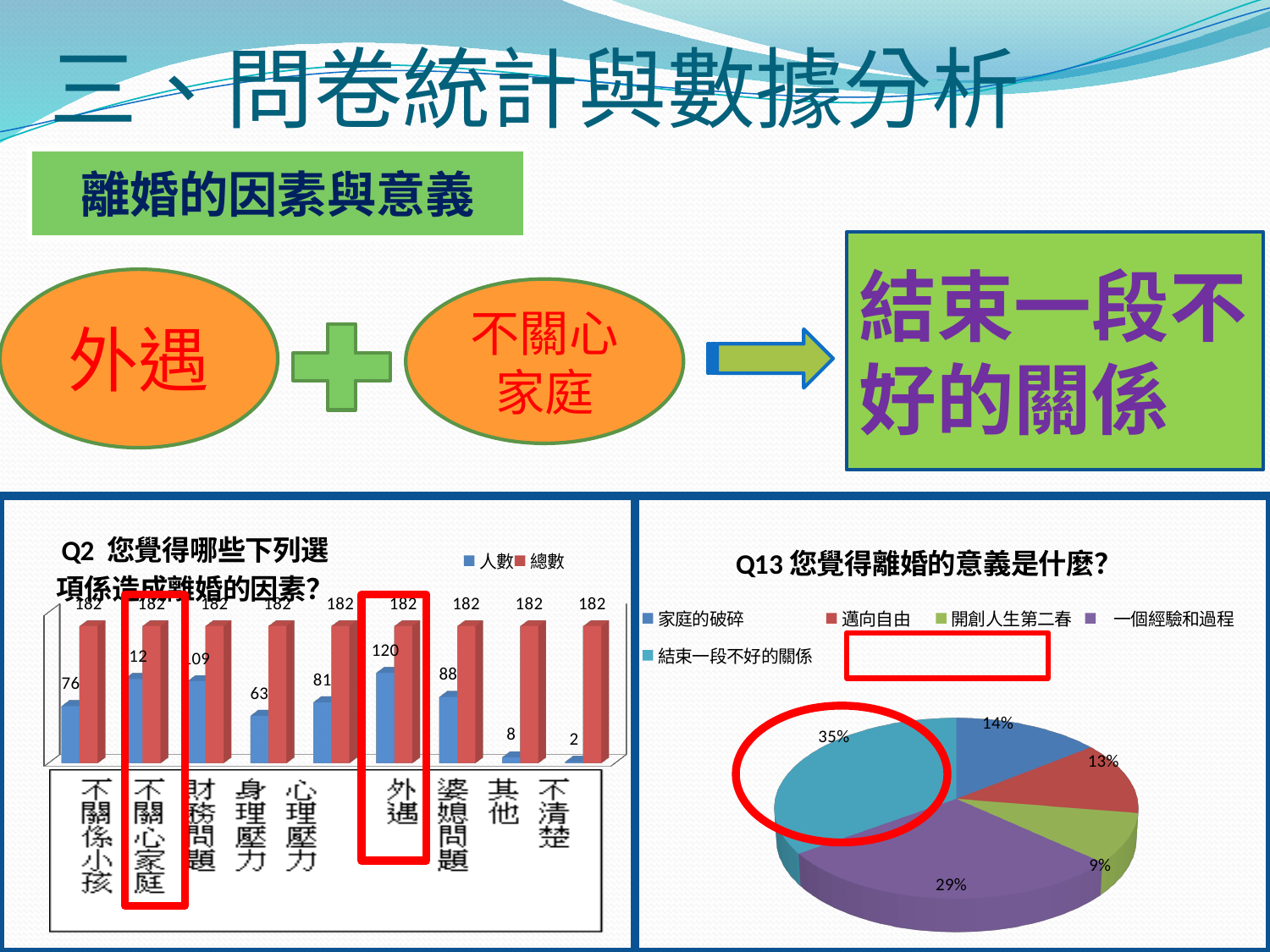
In the Q2 bar chart, what is the difference between the 人數 values for 外遇 and 婆媳問題? 32 In the Q13 pie chart, which category has the smallest slice? 開創人生第二春 In the Q2 bar chart, which category has the lowest 人數 value? 不清楚 In the Q2 bar chart, what is the 人數 value for 不清楚? 2 In the Q2 bar chart, how many categories are shown on the x axis? 9 What kind of chart is the Q13 chart on the right? pie chart In the Q2 bar chart, what is the 人數 value for 不關係小孩? 76 In the Q13 pie chart, what share does 結束一段不好的關係 have? 35% In the Q2 bar chart, what is the 人數 value for 外遇? 120 In the Q2 bar chart, how many series does the legend list? 2 In the Q2 bar chart, which has a larger 人數 value, 心理壓力 or 身理壓力? 心理壓力 In the Q2 bar chart, which category has the highest 人數 value? 外遇